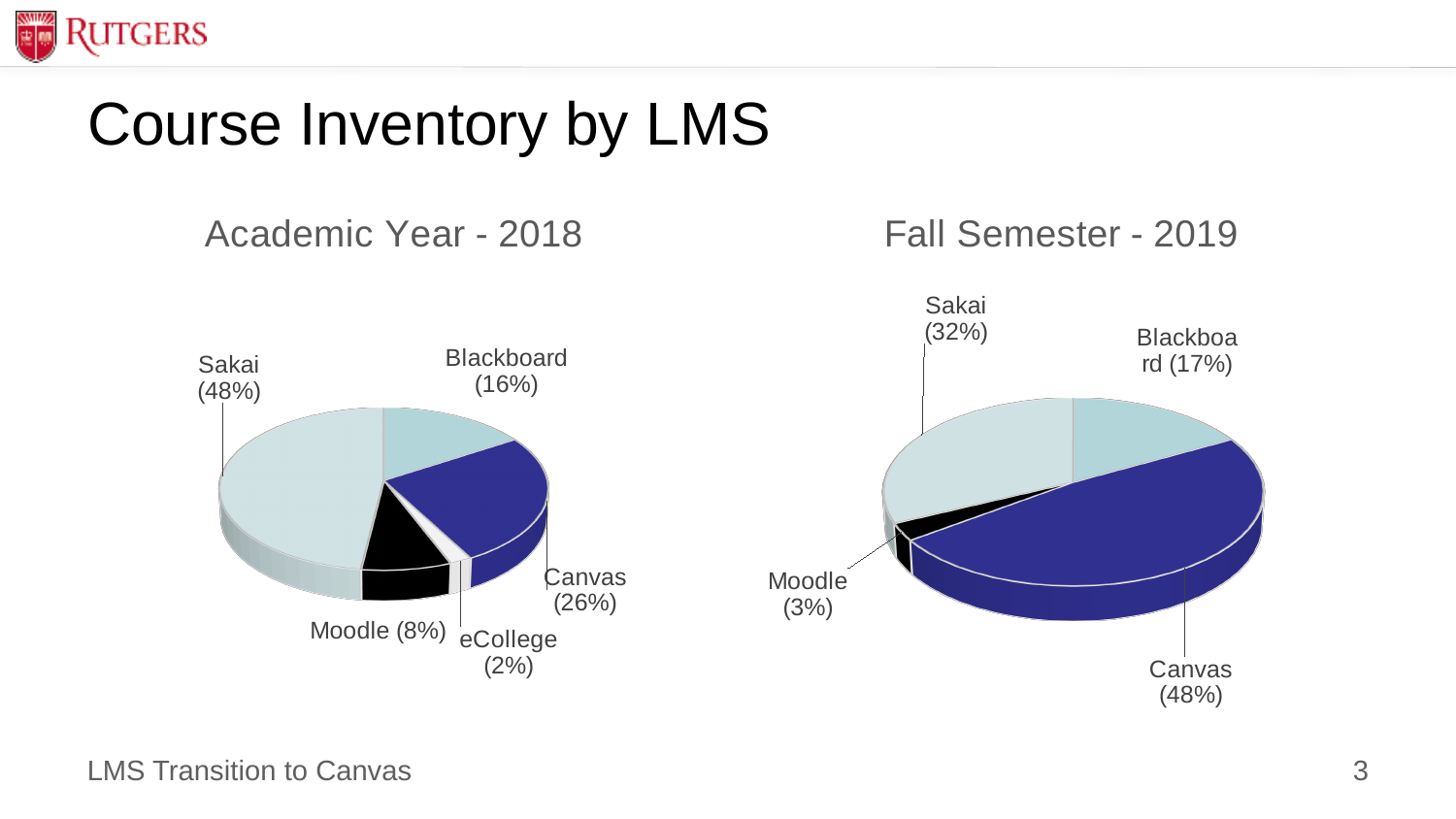
In the Academic Year - 2018 chart, what share does Canvas have? 26% In the Academic Year - 2018 chart, how many slices does the pie have? 5 In the Academic Year - 2018 chart, what is the difference between the Sakai share and the Canvas share? 22% What kind of chart is the Academic Year - 2018 chart? Pie chart In the Academic Year - 2018 chart, what share does Sakai have? 48% In the Fall Semester - 2019 chart, which is larger, the Sakai share or the Blackboard share? Sakai In the Fall Semester - 2019 chart, which LMS has the largest share? Canvas In the Academic Year - 2018 chart, which LMS has the smallest share? eCollege What is the title of the chart on the right side of the slide? Fall Semester - 2019 In the Fall Semester - 2019 chart, what share does Moodle have? 3% In the Fall Semester - 2019 chart, how many slices does the pie have? 4